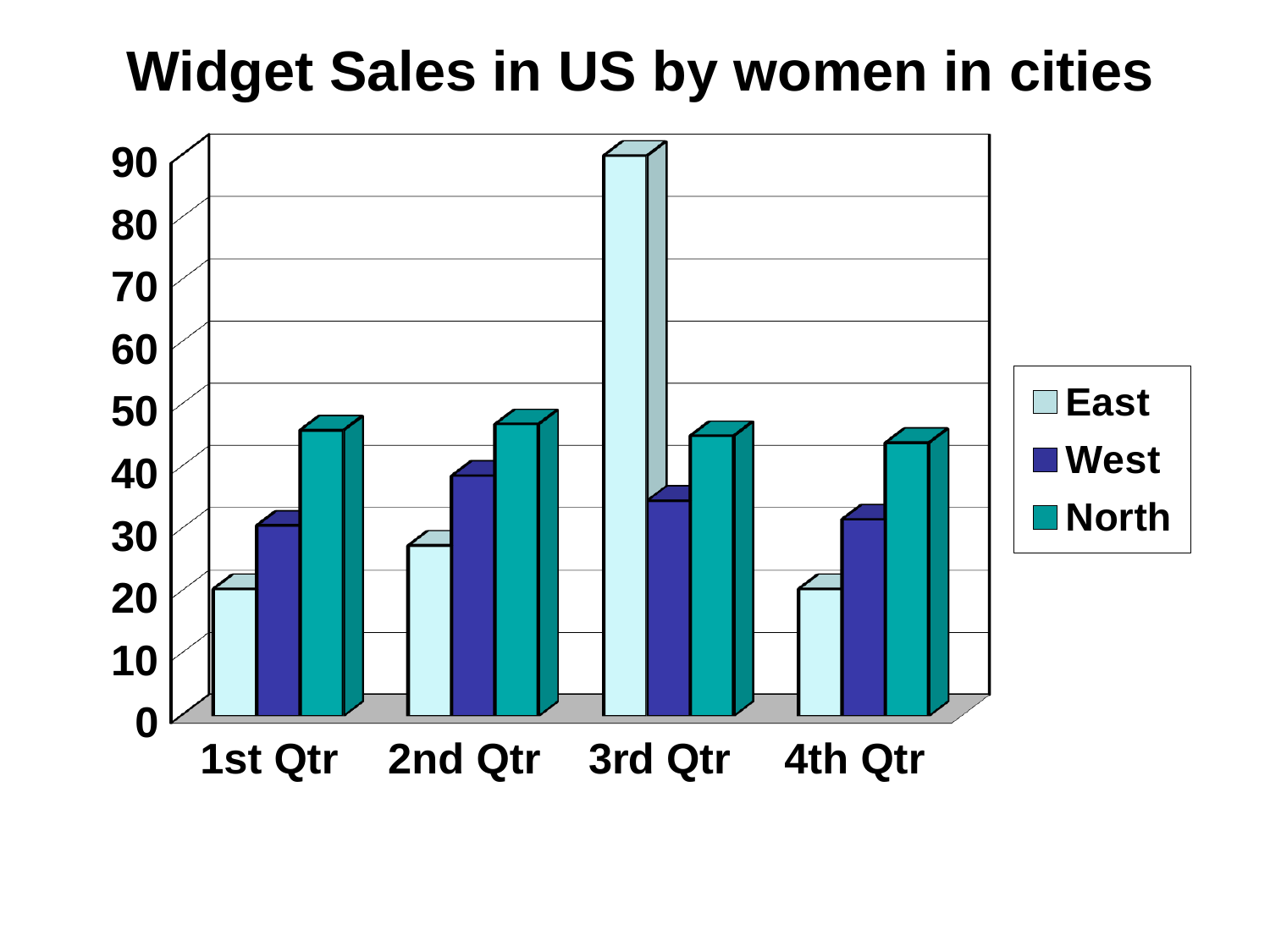
What kind of chart is shown on the slide? bar chart Is the West value for 2nd Qtr greater or less than 30? greater How many quarters are shown on the x axis? 4 How many series does the legend list? 3 Is the East value for 1st Qtr greater or less than 30? less Is the East value for 3rd Qtr greater or less than 80? greater Which quarter has the highest East value? 3rd Qtr What is the title of the chart? Widget Sales in US by women in cities Which series is shown in the lightest colour in the legend? East In 1st Qtr, which is larger, the East value or the North value? North In 3rd Qtr, which is larger, the East value or the West value? East